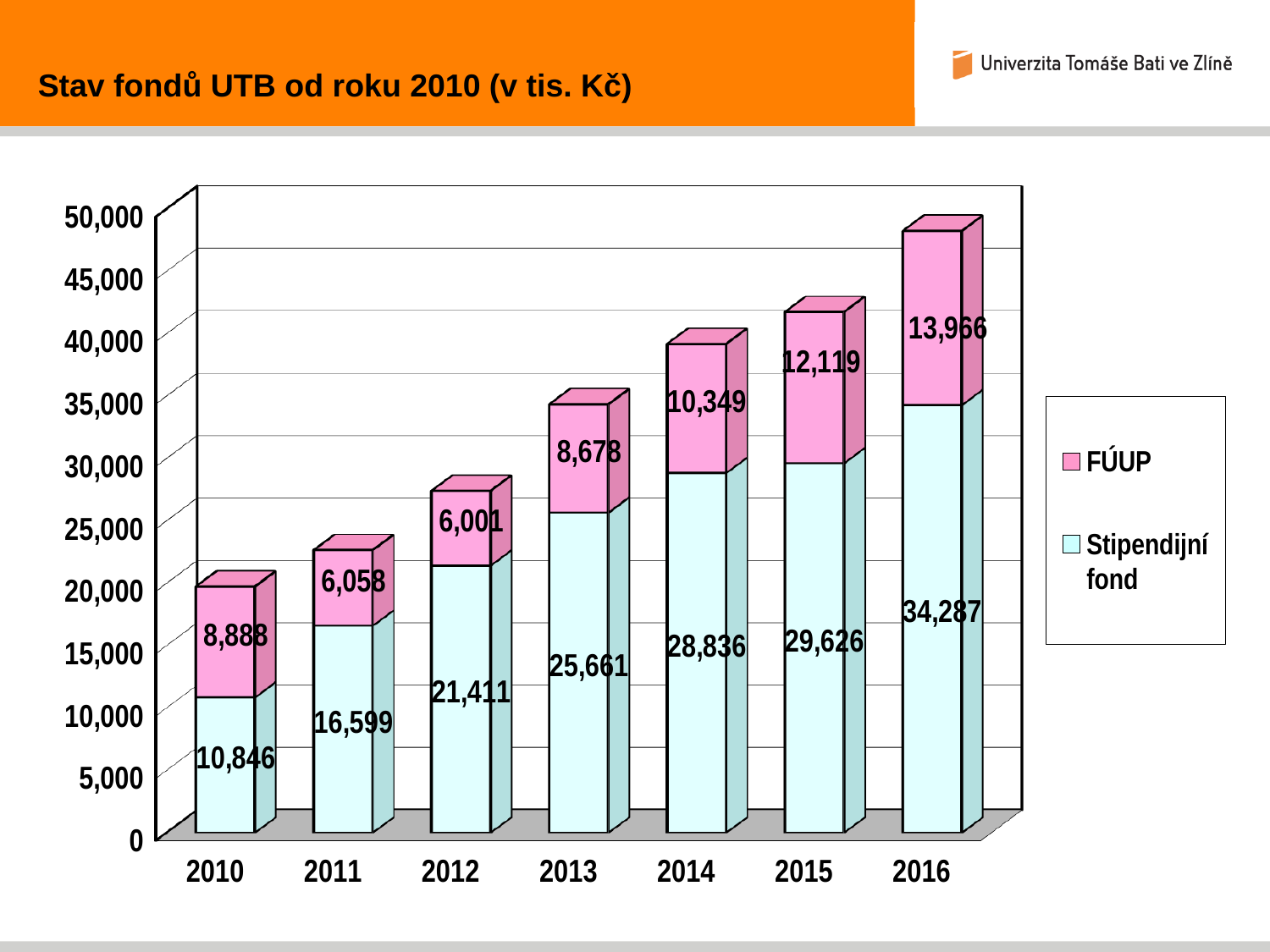
In which year is the Stipendijní fond value highest? 2016 What is the value of Stipendijní fond in 2010? 10,846 What is the value of FÚUP in 2013? 8,678 In which year is the FÚUP value lowest? 2012 How many years are shown on the x axis? 7 What is the total of the stacked bar for 2010? 19,734 What is the value of Stipendijní fond in 2016? 34,287 What is the total of the stacked bar for 2016? 48,253 Which is larger in 2010: FÚUP or Stipendijní fond? Stipendijní fond What is the difference between the Stipendijní fond values in 2016 and 2015? 4,661 How many series does the legend list? 2 Does the Stipendijní fond value rise or fall from 2010 to 2016? rise